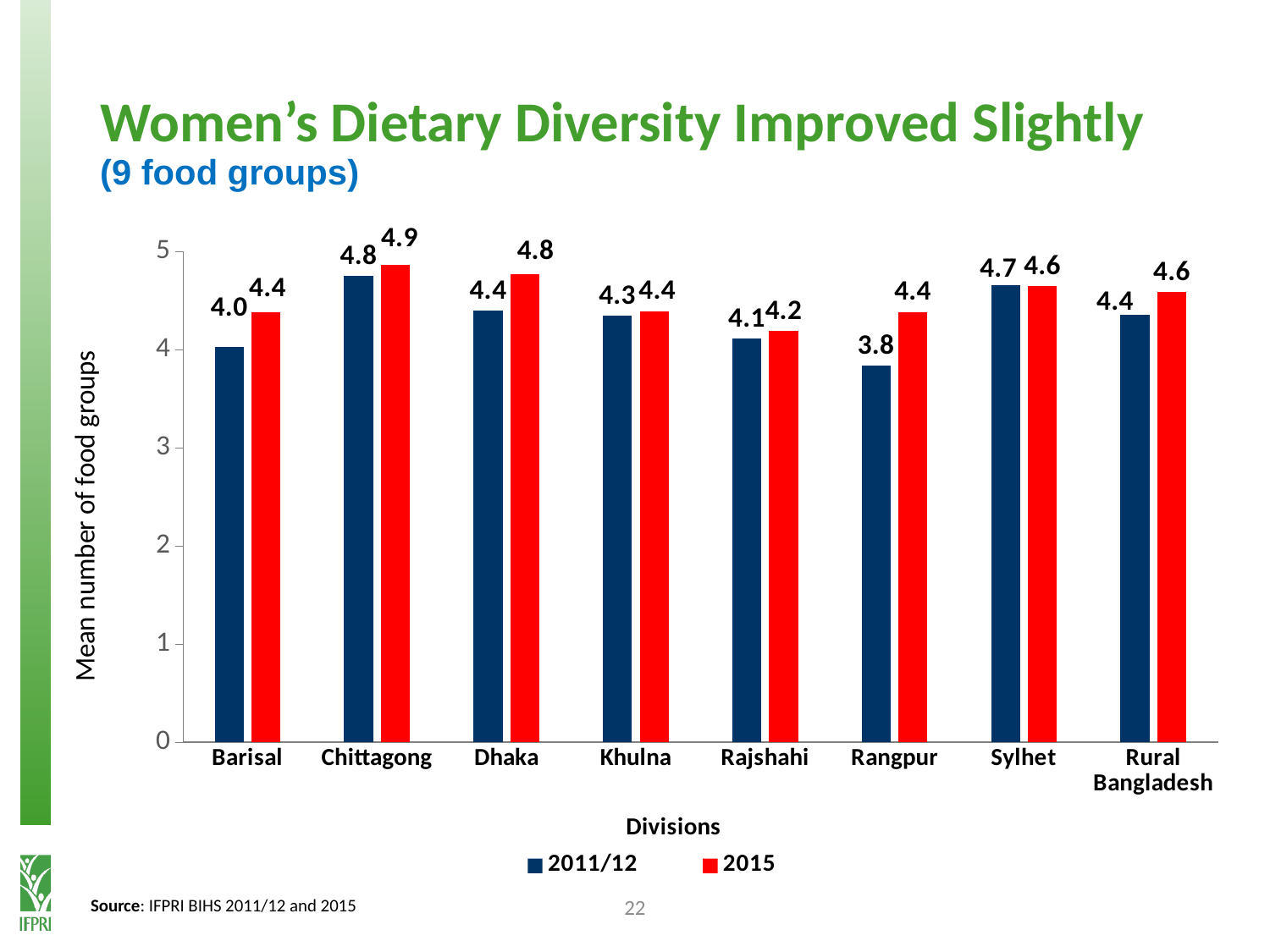
How many categories are shown on the x axis? 8 Which division has the highest value in the 2011/12 series? Chittagong How many series does the legend list? 2 What is the value for Rural Bangladesh in the 2015 series? 4.6 Which is larger for Sylhet, the 2011/12 value or the 2015 value? 2011/12 Which division has the lowest value in the 2011/12 series? Rangpur What kind of chart is shown on the slide? bar chart What is the value for Chittagong in the 2015 series? 4.9 What is the value for Rangpur in the 2011/12 series? 3.8 What is the difference between the 2015 and 2011/12 values for Rangpur? 0.6 Which category has the lowest value in the 2015 series? Rajshahi Is the 2011/12 value for Rangpur greater or less than 4? less